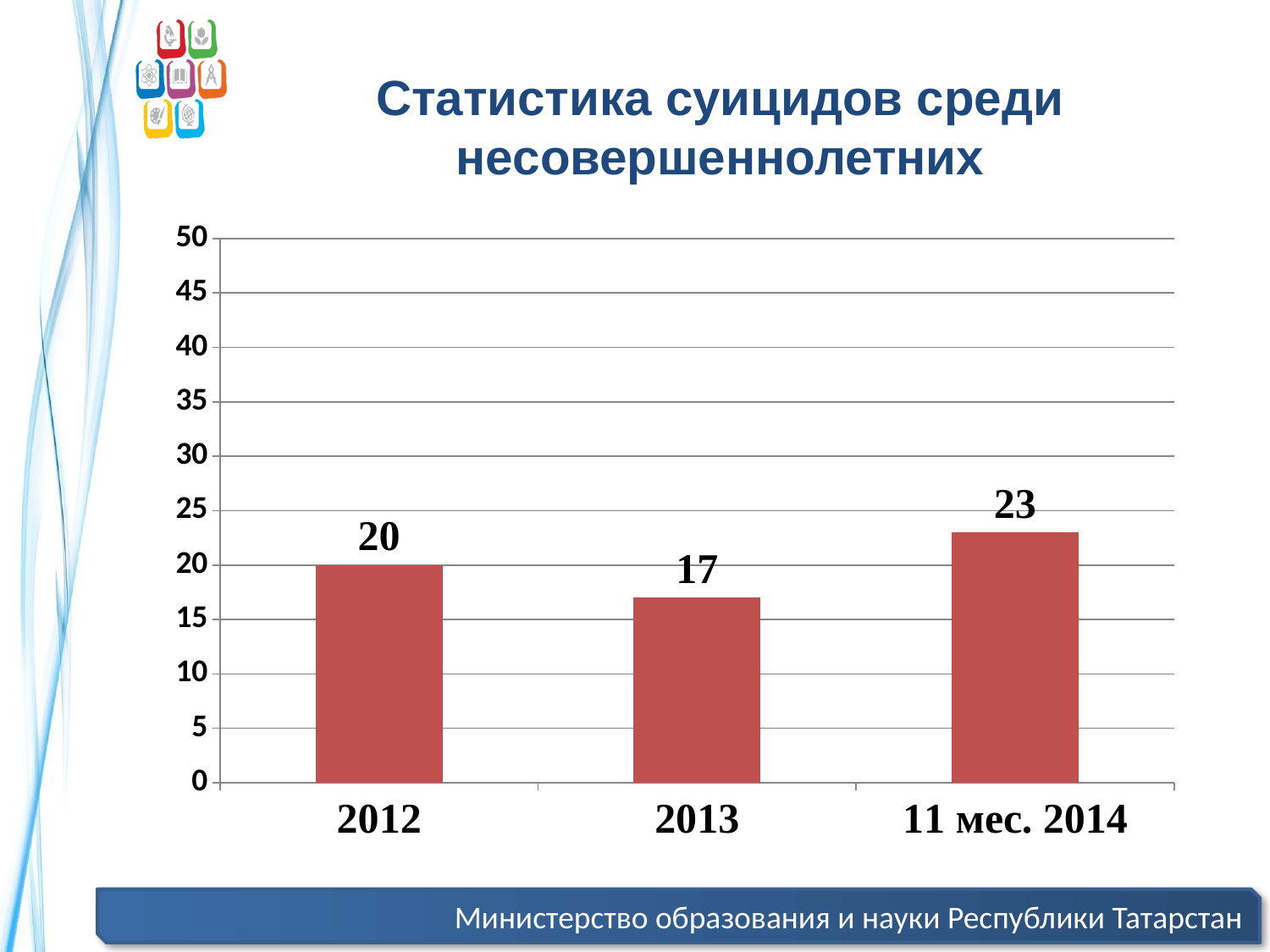
Which category has the lowest value? 2013 Which is larger, the value for 2012 or the value for 11 мес. 2014? 11 мес. 2014 Is the value for 2013 greater or less than 20? less What is the value for 11 мес. 2014? 23 What is the difference between the values for 11 мес. 2014 and 2013? 6 What is the title of the chart on the slide? Статистика суицидов среди несовершеннолетних What kind of chart is shown on the slide? bar chart What is the value for 2013? 17 Which category has the highest value? 11 мес. 2014 What is the difference between the values for 2012 and 2013? 3 What is the value for 2012? 20 How many categories are shown on the x axis? 3